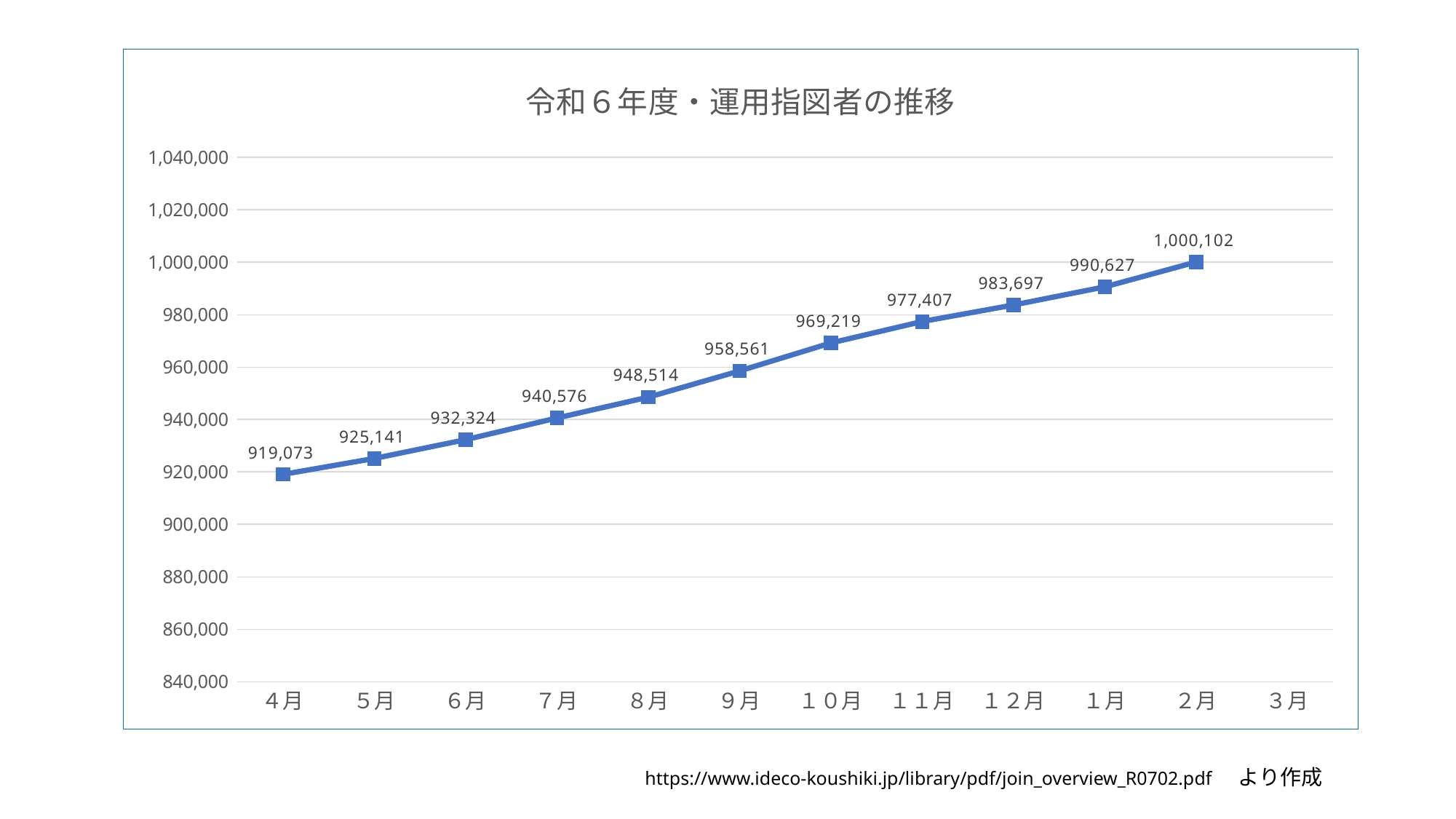
What is the value for 2月 in the chart? 1,000,102 What is the difference between the values for 2月 and 4月? 81,029 Is the value for 12月 greater or less than 1,000,000? less How many data points are plotted on the line? 11 Which is larger, the value for 7月 or the value for 11月? 11月 What is the value for 10月 in the chart? 969,219 What is the value for 4月 in the chart? 919,073 Which month has the highest value in the chart? 2月 Do the values rise or fall from 4月 to 2月? rise What is the difference between the values for 10月 and 9月? 10,658 Which month has the lowest plotted value in the chart? 4月 What kind of chart is shown on the slide? line chart